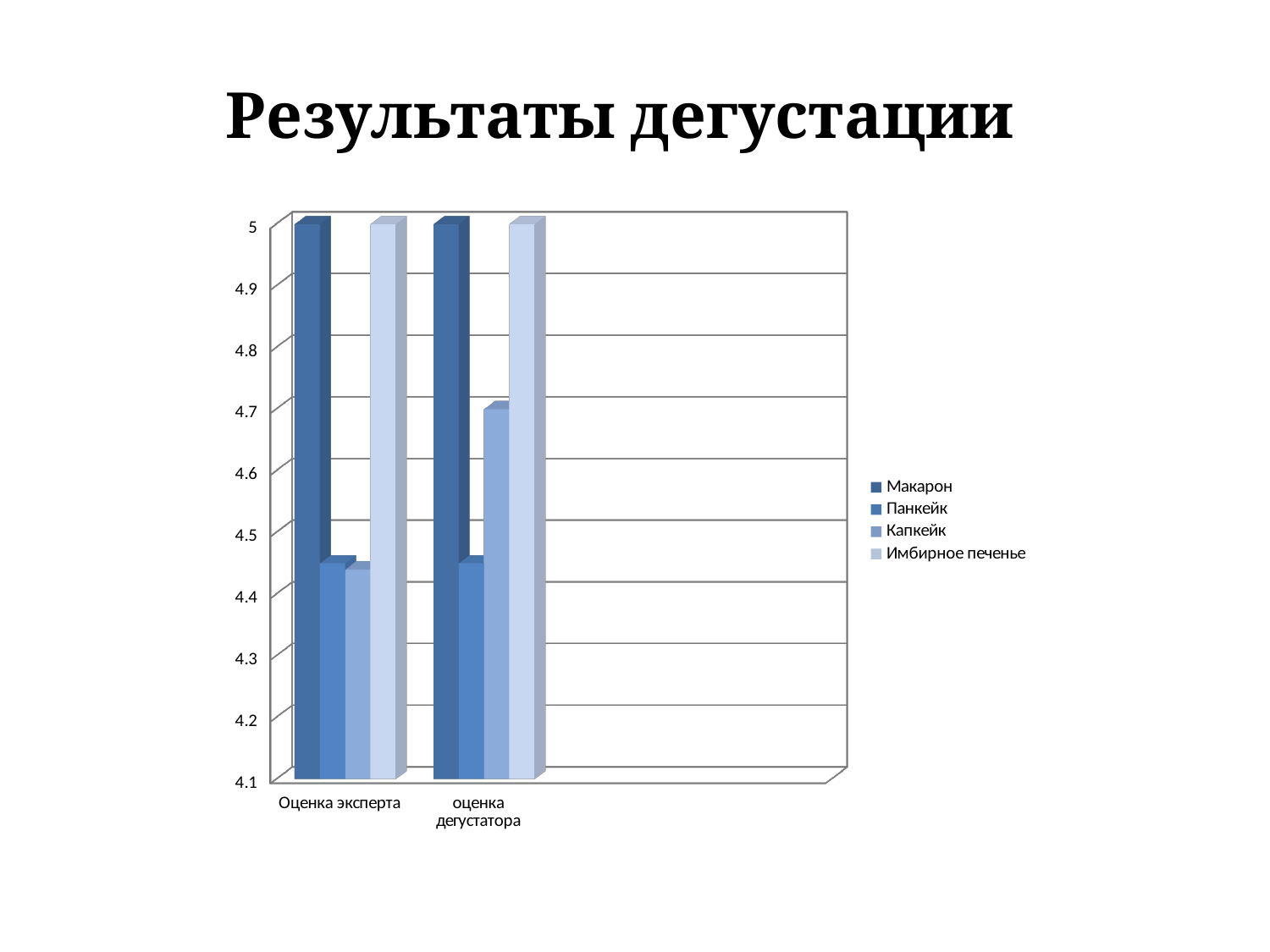
What is the title of the slide? Результаты дегустации In the Оценка эксперта category, which is larger: Макарон or Панкейк? Макарон Which series is listed last in the legend? Имбирное печенье Is the value for Панкейк in the Оценка эксперта category greater or less than 4.5? less Which is larger for Капкейк: the value for Оценка эксперта or for оценка дегустатора? оценка дегустатора How many series does the legend list? 4 In the оценка дегустатора category, which series has the lowest value? Панкейк What kind of chart is shown on the slide? bar chart Is the value for Макарон in the Оценка эксперта category greater or less than 4.8? greater How many categories are shown on the x axis? 2 Is the value for Капкейк in the оценка дегустатора category greater or less than 4.6? greater